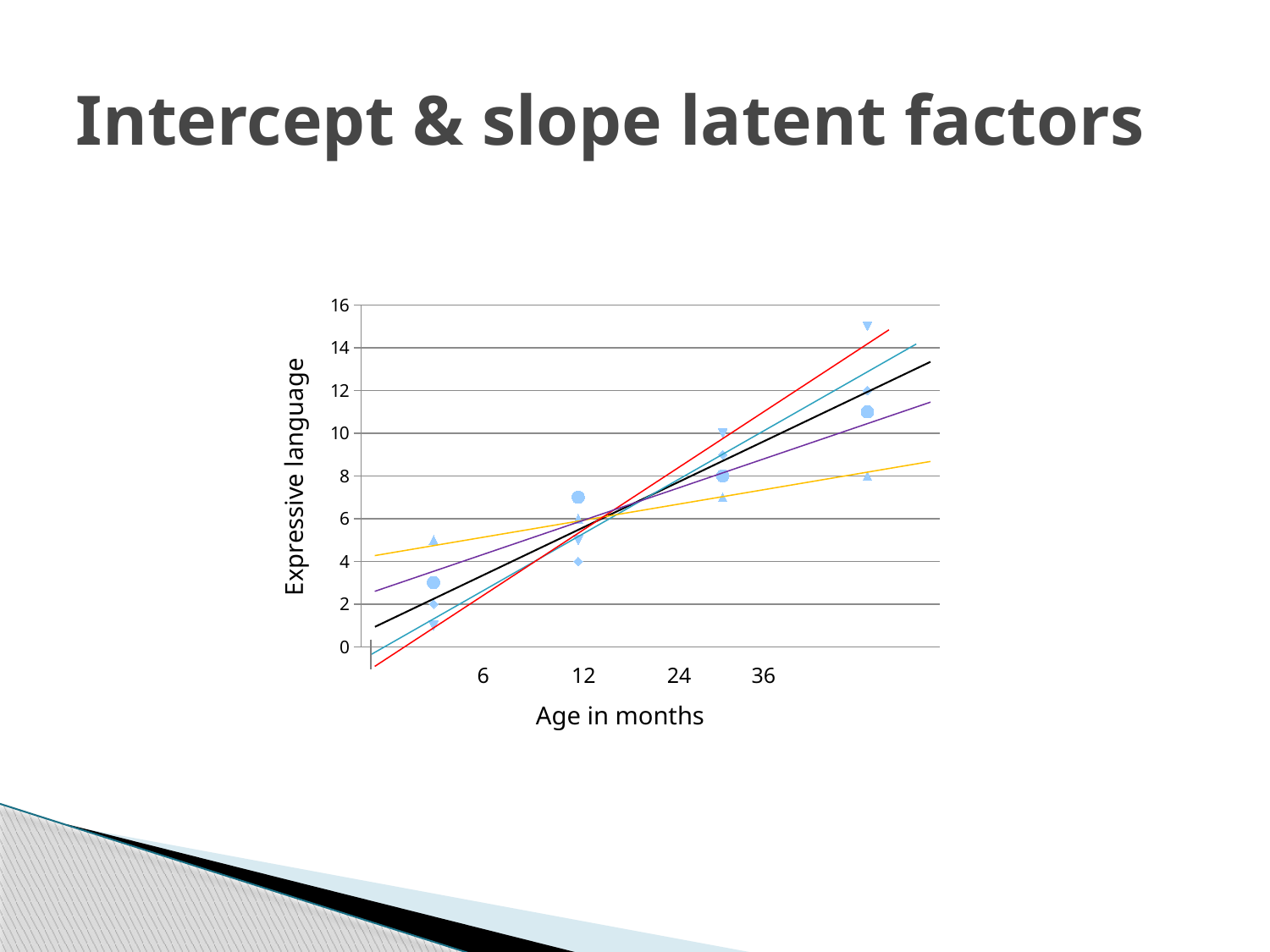
Is the large circle plotted at age 12 greater or less than 6? greater What is the title of the chart's x axis? Age in months What kind of chart is shown on the slide? Scatter chart with trend lines Is the highest plotted point at the rightmost age greater or less than 14? greater Which trend line is steeper, the red line or the yellow line? The red line What is the highest value shown on the y axis? 16 Is the lowest plotted point at the leftmost age greater or less than 2? less What is the title of the chart's y axis? Expressive language How many age tick labels are shown on the x axis? 4 Do the plotted expressive language values rise or fall as age in months increases? Rise How many trend lines are drawn on the chart? 5